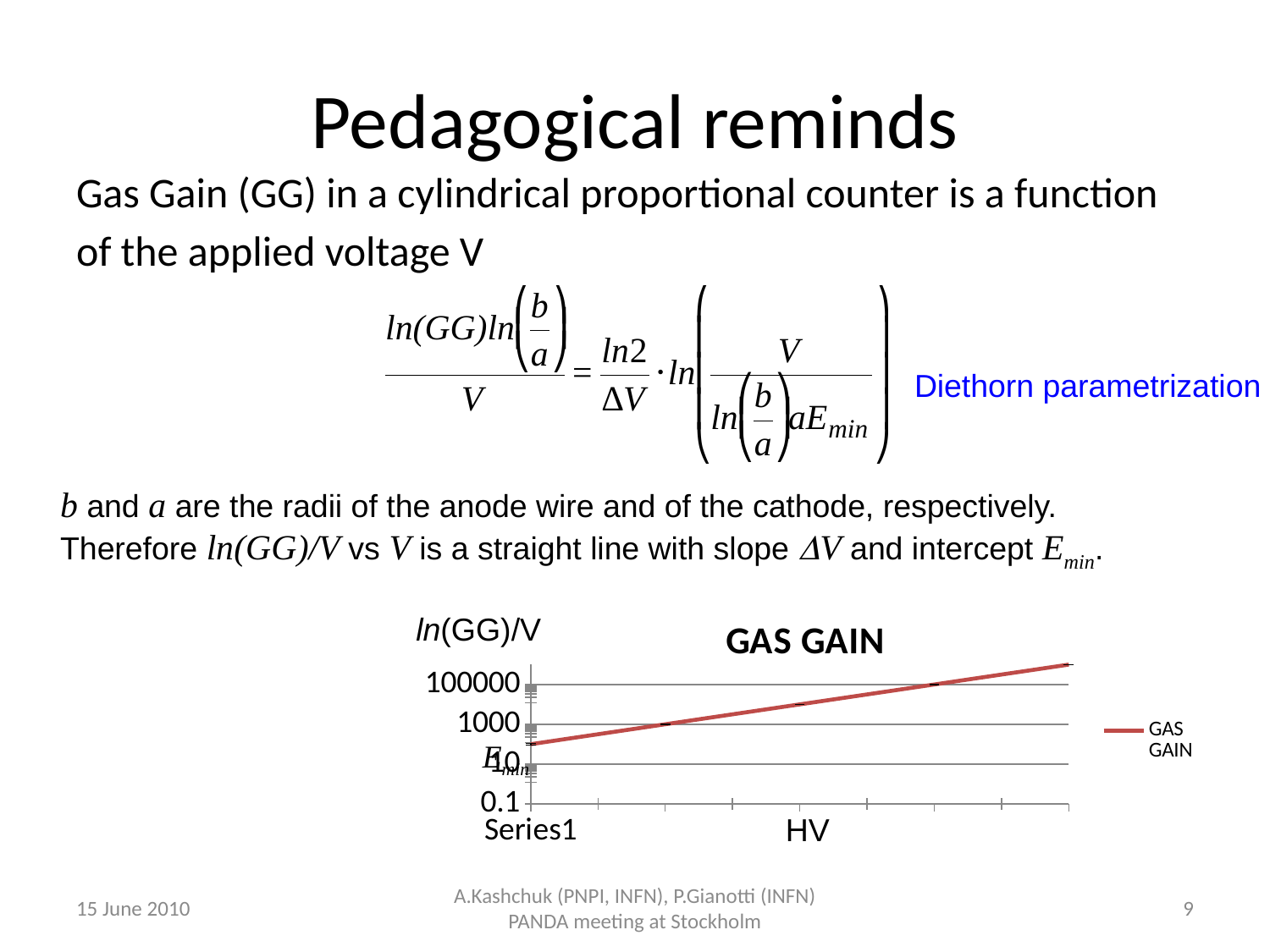
In the GAS GAIN chart, does the plotted line rise or fall as HV increases along the x axis? rise What kind of chart is the GAS GAIN chart? line chart What is the title of the chart on the slide? GAS GAIN How many series does the legend of the GAS GAIN chart list? 1 What label is shown on the x axis of the GAS GAIN chart? HV